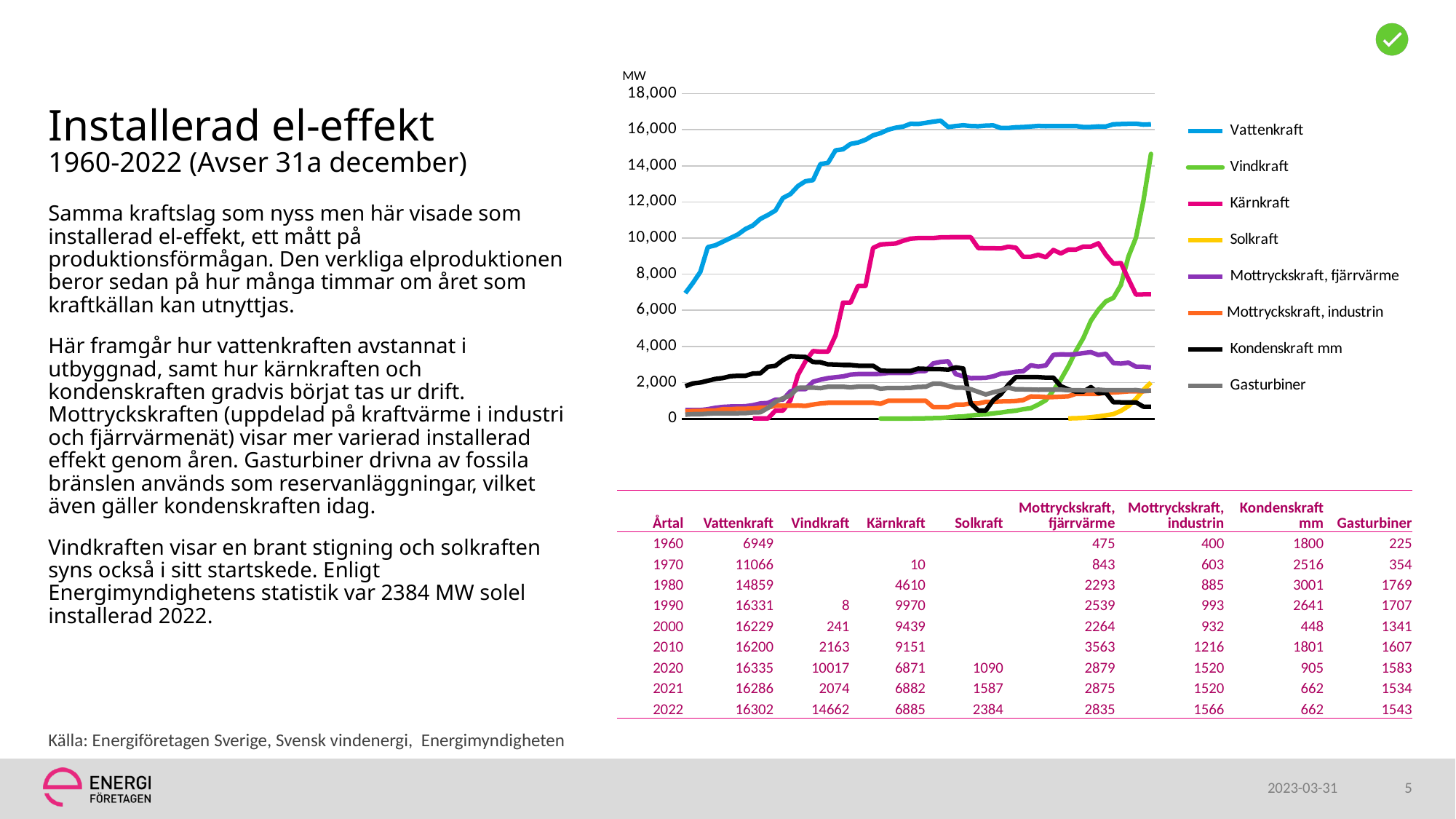
Does the Vindkraft line rise or fall towards the right end of the chart? rise Is the value of Vattenkraft at the right end of the chart greater or less than 16,000? greater According to the table, what was the installed capacity of Vindkraft in 2020? 10017 Which series reaches the highest value on the chart? Vattenkraft According to the table, what was the installed capacity of Solkraft in 2022? 2384 What unit is shown on the chart's vertical axis? MW By how much did Solkraft's installed capacity increase from 2021 to 2022 according to the table? 797 According to the table, what was the installed capacity of Vattenkraft in 2022? 16302 In 2022, which had the larger installed capacity, Vindkraft or Kärnkraft? Vindkraft What kind of chart is shown on the slide? line chart Is the value of Kärnkraft at the right end of the chart greater or less than 8,000? less How many series does the chart legend list? 8